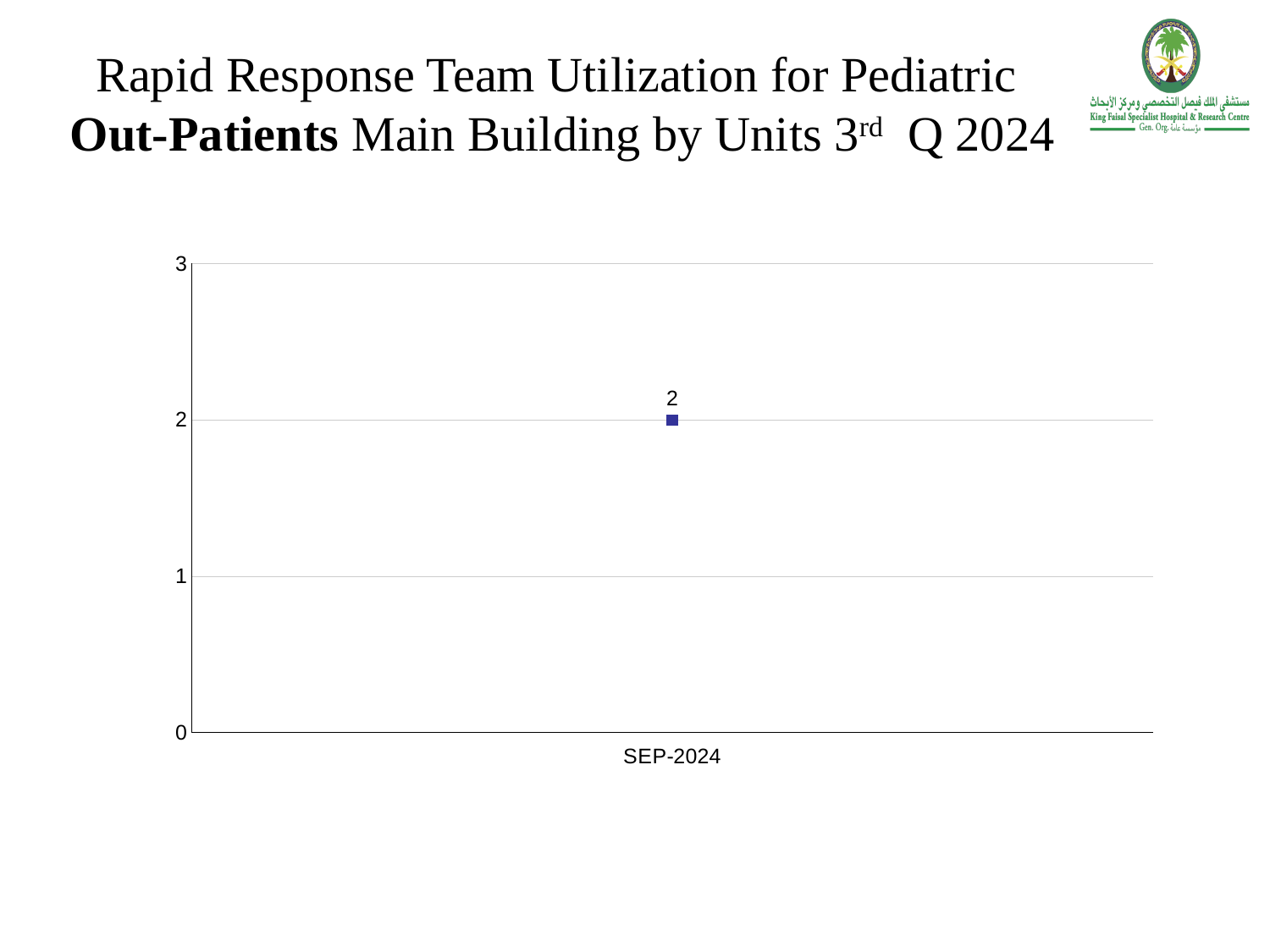
Is the value for SEP-2024 greater or less than 1? greater How many data points are plotted on the chart? 1 Is the value for SEP-2024 greater or less than 3? less What is the value plotted for SEP-2024? 2 What category label appears on the horizontal axis? SEP-2024 What is the highest value shown on the vertical axis? 3